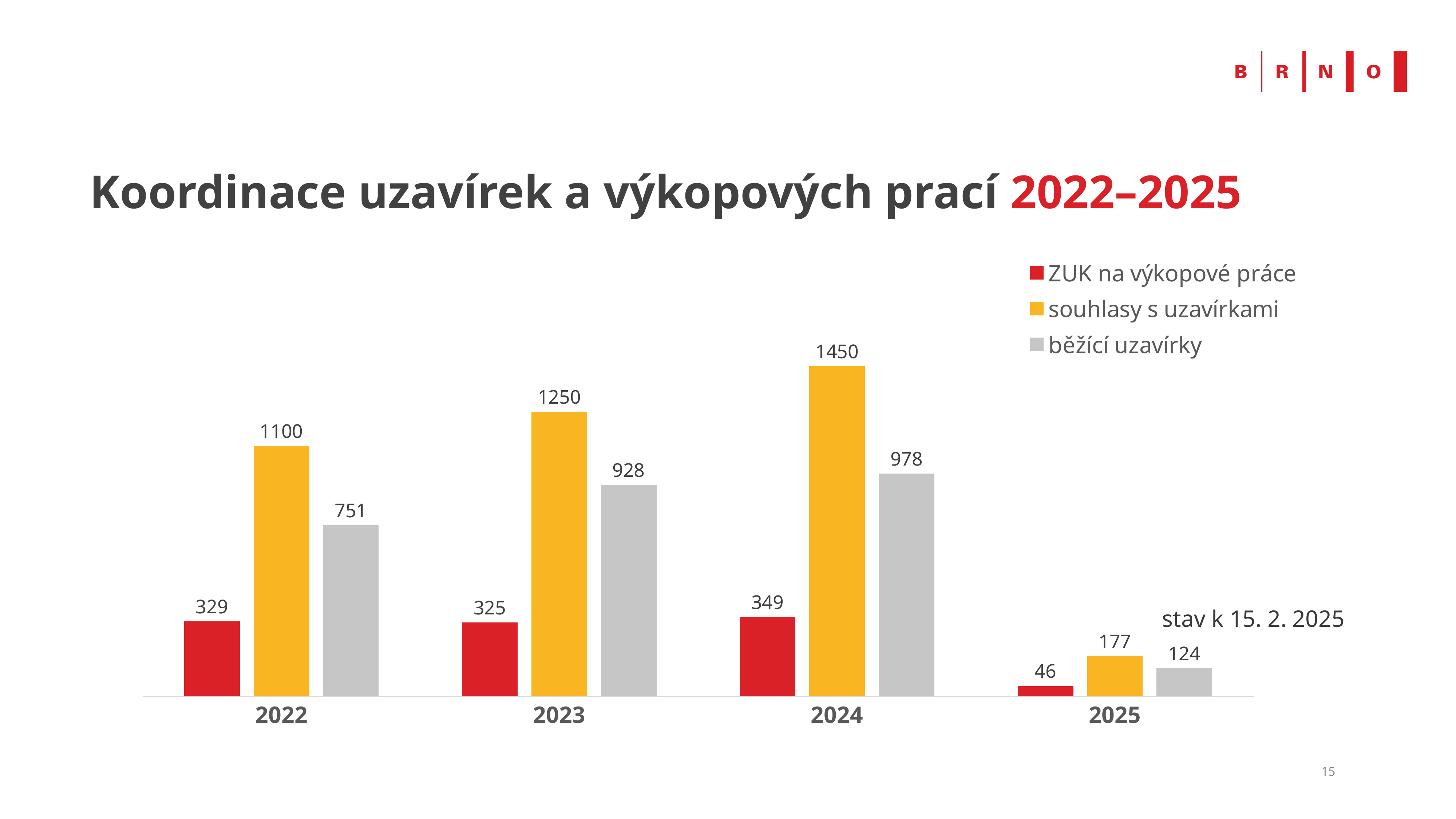
How many series does the legend list? 3 Which is larger: 'běžící uzavírky' in 2023 or in 2022? 2023 What is the value for 'ZUK na výkopové práce' in 2022? 329 Which colour represents 'běžící uzavírky' in the legend? grey How many years are shown on the x axis? 4 In which year is 'ZUK na výkopové práce' lowest? 2025 What is the value for 'běžící uzavírky' in 2025? 124 What is the value for 'souhlasy s uzavírkami' in 2024? 1450 What is the difference between 'souhlasy s uzavírkami' in 2024 and in 2023? 200 What kind of chart is shown on the slide? bar chart Does 'souhlasy s uzavírkami' rise or fall from 2022 to 2024? rise In which year is 'souhlasy s uzavírkami' highest? 2024